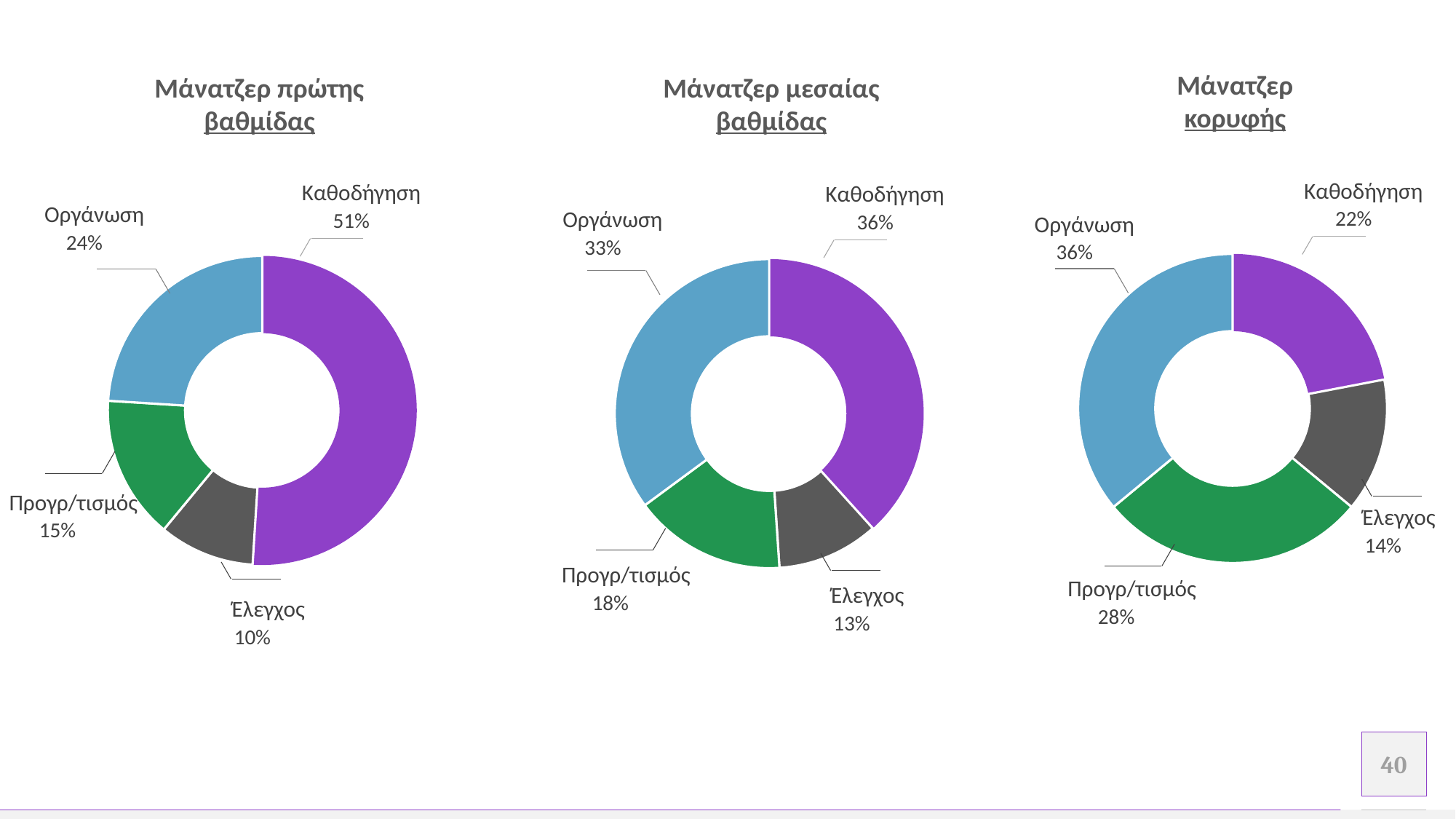
In the 'Μάνατζερ κορυφής' chart, what is the difference between Προγρ/τισμός and Καθοδήγηση? 6% In the 'Μάνατζερ μεσαίας βαθμίδας' chart, which category has the largest share? Καθοδήγηση In the 'Μάνατζερ κορυφής' chart, what is the value for Έλεγχος? 14% In the 'Μάνατζερ κορυφής' chart, which category has the largest share? Οργάνωση In the 'Μάνατζερ μεσαίας βαθμίδας' chart, what is the value for Προγρ/τισμός? 18% What kind of chart is the 'Μάνατζερ πρώτης βαθμίδας' chart? Doughnut chart How many charts are shown on the slide? 3 In the 'Μάνατζερ πρώτης βαθμίδας' chart, which category has the smallest share? Έλεγχος How many categories does the 'Μάνατζερ κορυφής' chart show? 4 Which is larger in the 'Μάνατζερ μεσαίας βαθμίδας' chart: Οργάνωση or Έλεγχος? Οργάνωση In the 'Μάνατζερ πρώτης βαθμίδας' chart, what is the difference between Καθοδήγηση and Οργάνωση? 27% In the 'Μάνατζερ πρώτης βαθμίδας' chart, what is the value for Καθοδήγηση? 51%